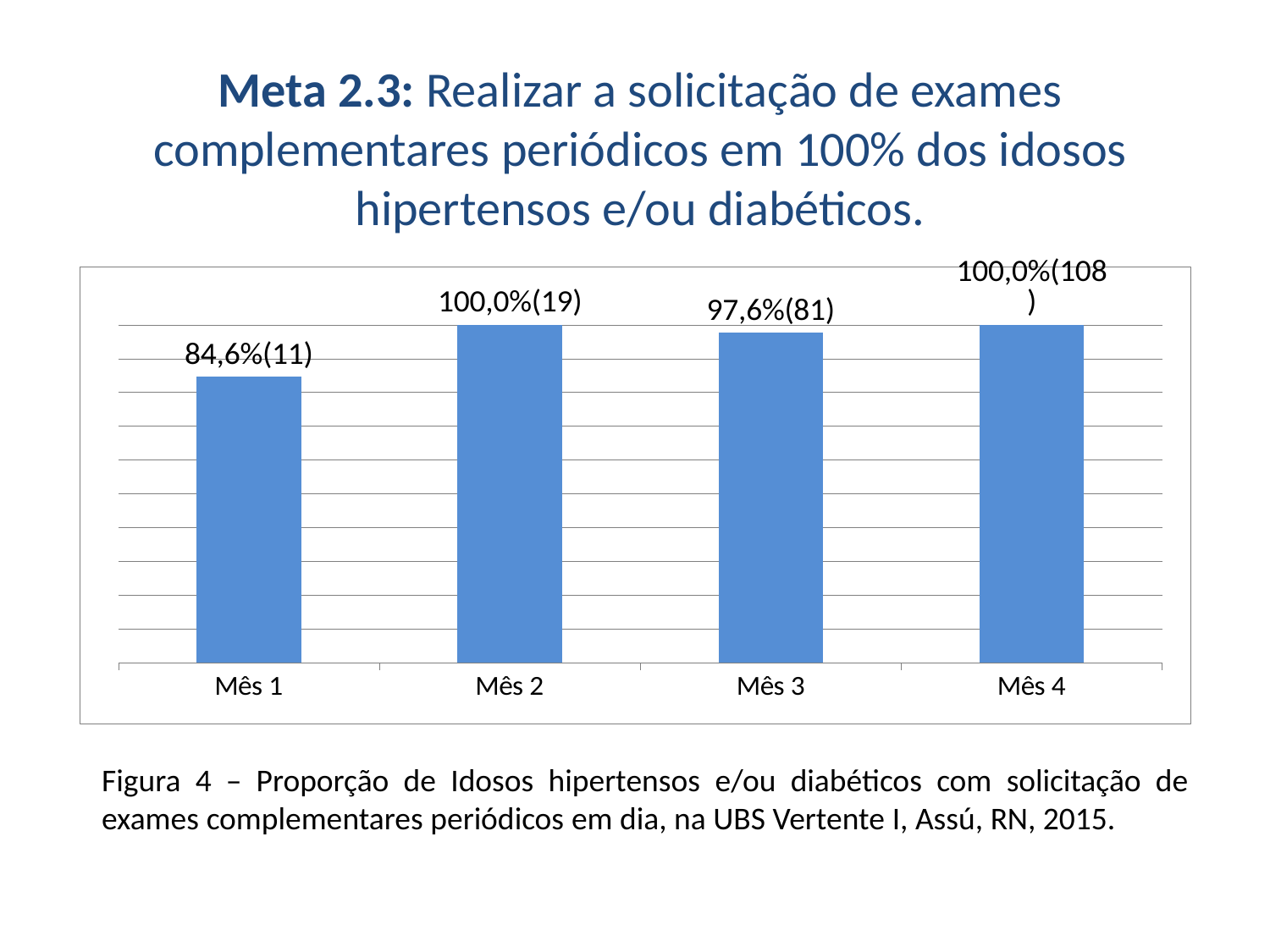
What is the value shown for Mês 3? 97,6%(81) What percentage is shown for Mês 2? 100,0% Which month has the lowest value? Mês 1 What is the value shown for Mês 4? 100,0%(108) What is the value shown for Mês 1? 84,6%(11) Does the value rise or fall from Mês 1 to Mês 2? Rise What is the difference in percentage points between Mês 2 and Mês 1? 15,4 What kind of chart is shown on the slide? Bar chart How many months are shown on the x axis? 4 What is the difference in percentage points between Mês 4 and Mês 3? 2,4 Which has a larger value, Mês 1 or Mês 3? Mês 3 Which months share the highest value of 100,0%? Mês 2 and Mês 4